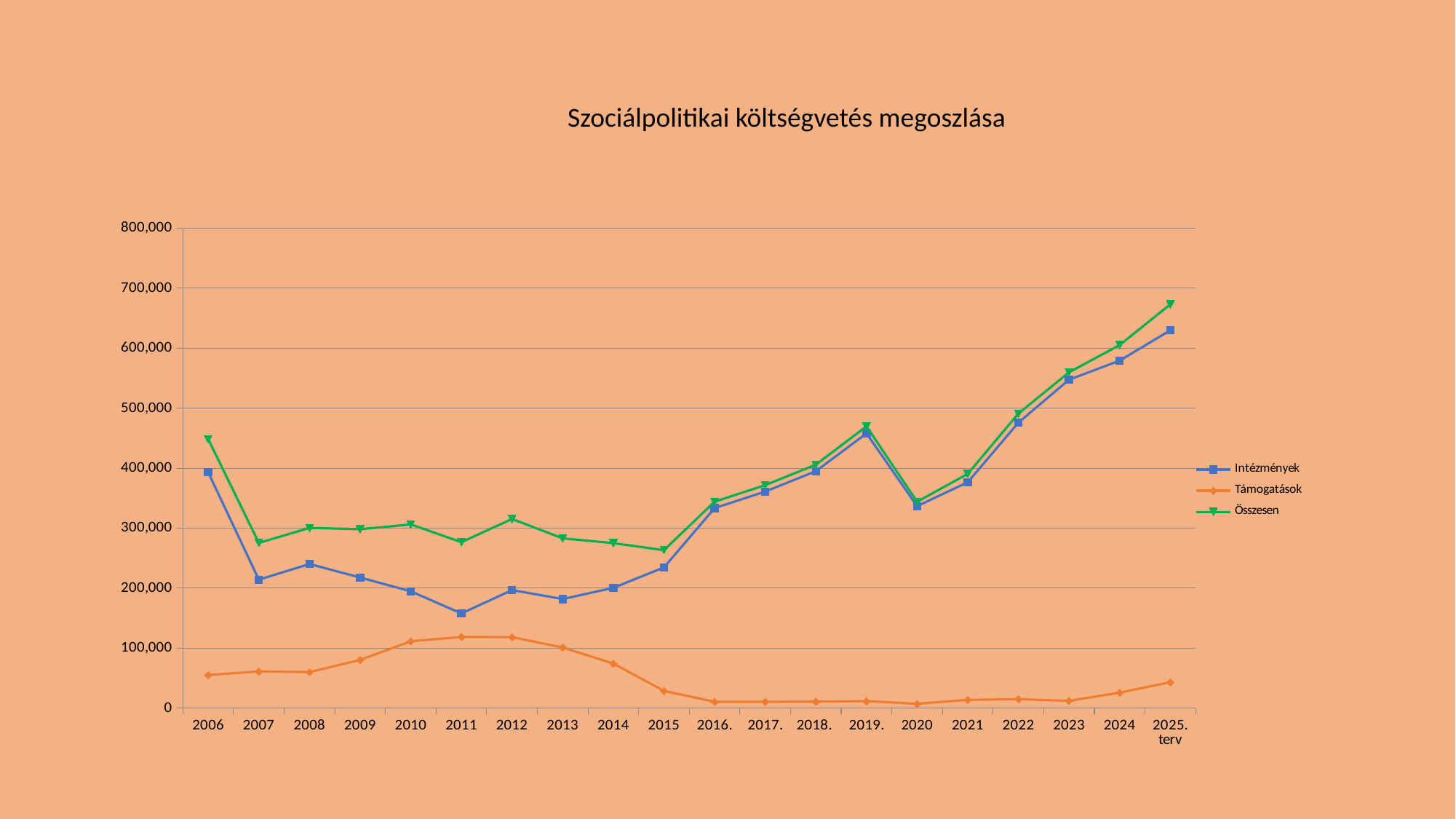
Which is larger for Intézmények: the value in 2007 or the value in 2008? 2008 How many series does the legend list? 3 In which year does the Összesen series reach its highest value? 2025. terv Is the value for Támogatások in 2010 greater or less than 100,000? greater In which year does the Intézmények series reach its lowest value? 2011 What is the title of the chart? Szociálpolitikai költségvetés megoszlása Does the Intézmények series rise or fall from 2020 to 2025. terv? rise Is the value for Intézmények in 2006 greater or less than 300,000? greater Which series is drawn in green? Összesen Is the value for Összesen in 2020 greater or less than 400,000? less What kind of chart is shown on the slide? line chart How many years (categories) are shown on the x axis? 20